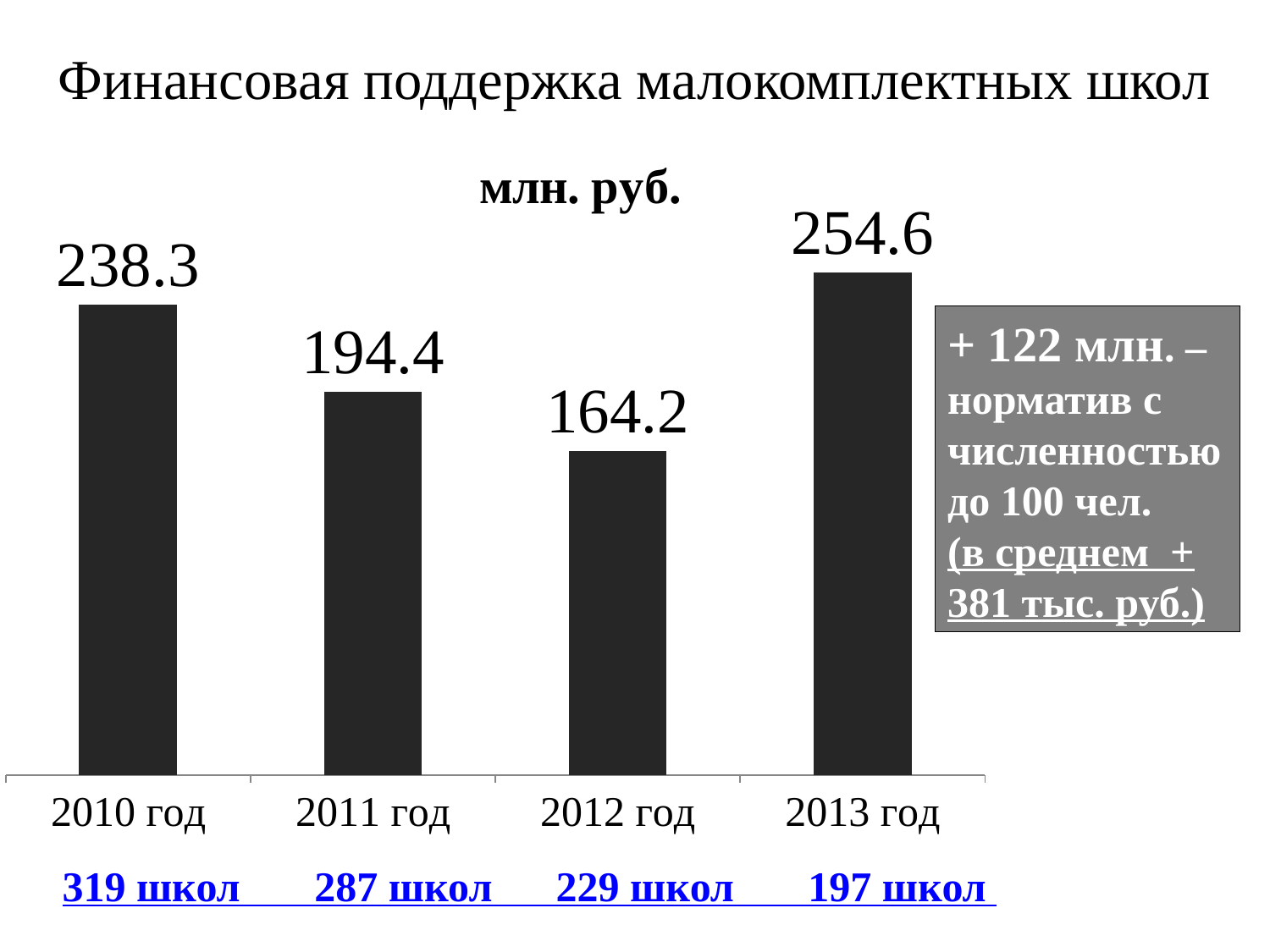
What is the value for 2010 год? 238.3 What is the chart's title? млн. руб. What kind of chart is shown on the slide? bar chart What is the difference between the values for 2013 год and 2012 год? 90.4 Which year has the highest value? 2013 год What is the value for 2012 год? 164.2 What is the value for 2013 год? 254.6 Which is larger, the value for 2010 год or the value for 2013 год? 2013 год Which year has the lowest value? 2012 год What is the difference between the values for 2010 год and 2011 год? 43.9 How many years are shown on the chart? 4 Do the values rise or fall from 2010 год to 2012 год? fall